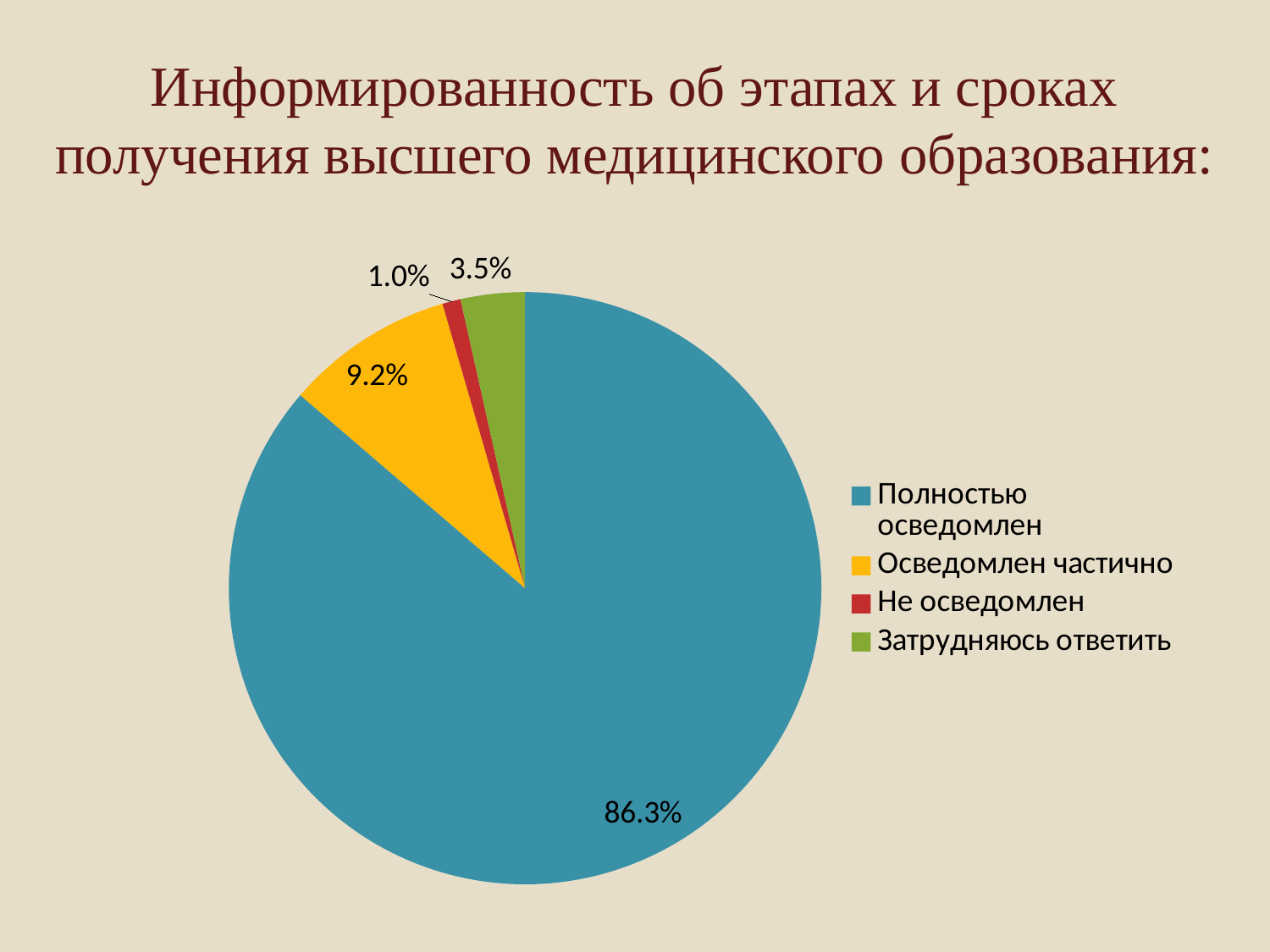
What share of the pie is labelled "Осведомлен частично"? 9.2% What share of the pie is labelled "Не осведомлен"? 1.0% Which is larger: the share for "Осведомлен частично" or the share for "Затрудняюсь ответить"? Осведомлен частично What is the difference between the shares for "Затрудняюсь ответить" and "Не осведомлен"? 2.5% Which category has the largest slice of the pie? Полностью осведомлен Which category has the smallest slice of the pie? Не осведомлен How many categories does the legend list? 4 What kind of chart is shown on the slide? pie chart What is the difference between the shares for "Полностью осведомлен" and "Осведомлен частично"? 77.1% What share of the pie is labelled "Полностью осведомлен"? 86.3% What colour is the slice for "Не осведомлен"? red What share of the pie is labelled "Затрудняюсь ответить"? 3.5%